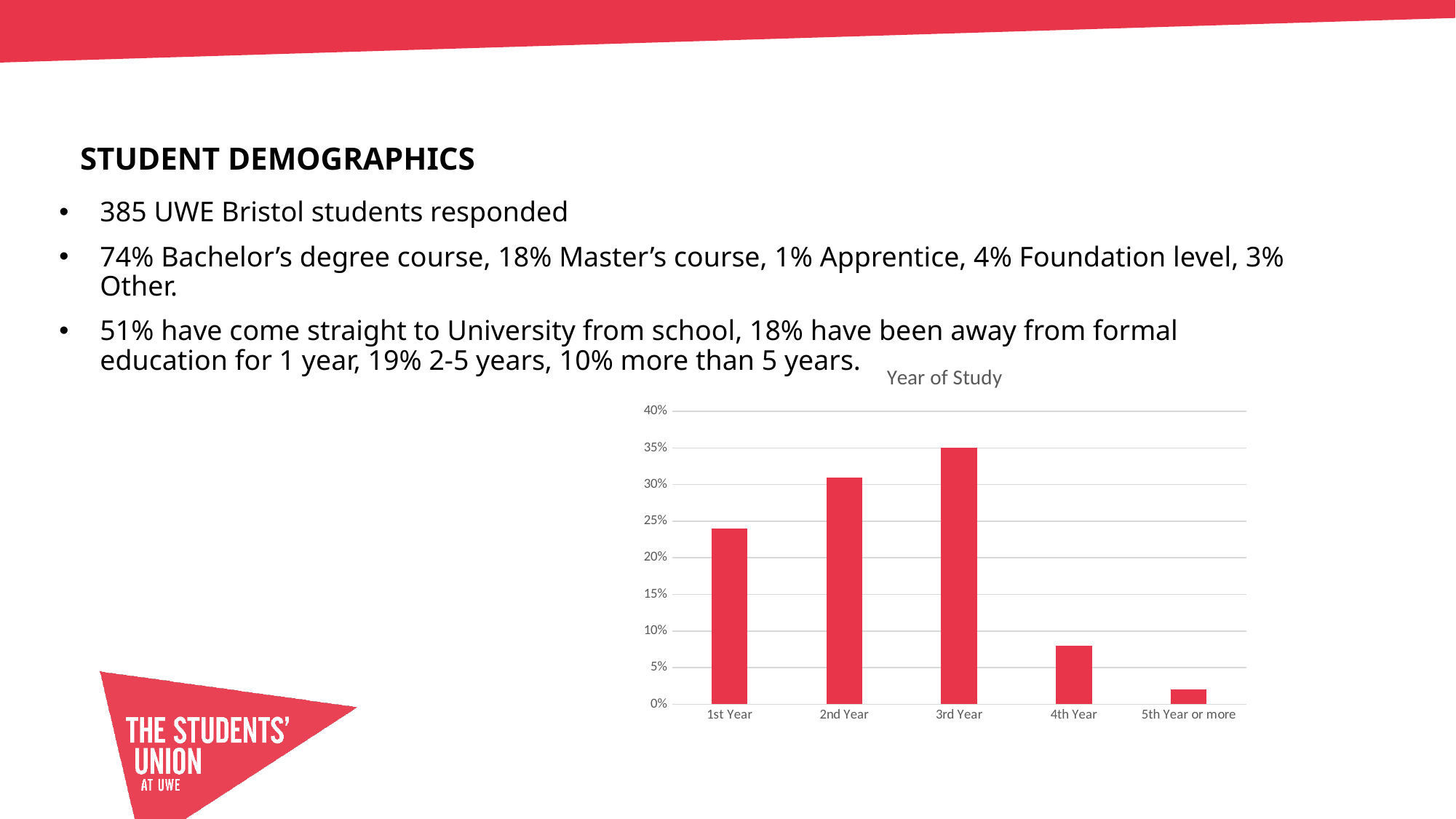
Which is larger, the value for 1st Year or the value for 2nd Year? 2nd Year Is the value for 4th Year greater or less than 10%? less Which year of study has the lowest value in the chart? 5th Year or more What kind of chart is shown on the slide? bar chart What is the title of the chart? Year of Study Is the value for 1st Year greater or less than 20%? greater Which is larger, the value for 4th Year or the value for 5th Year or more? 4th Year Which year of study has the highest value in the chart? 3rd Year How many categories are shown on the x axis of the chart? 5 Do the values rise or fall from 3rd Year to 5th Year or more? fall